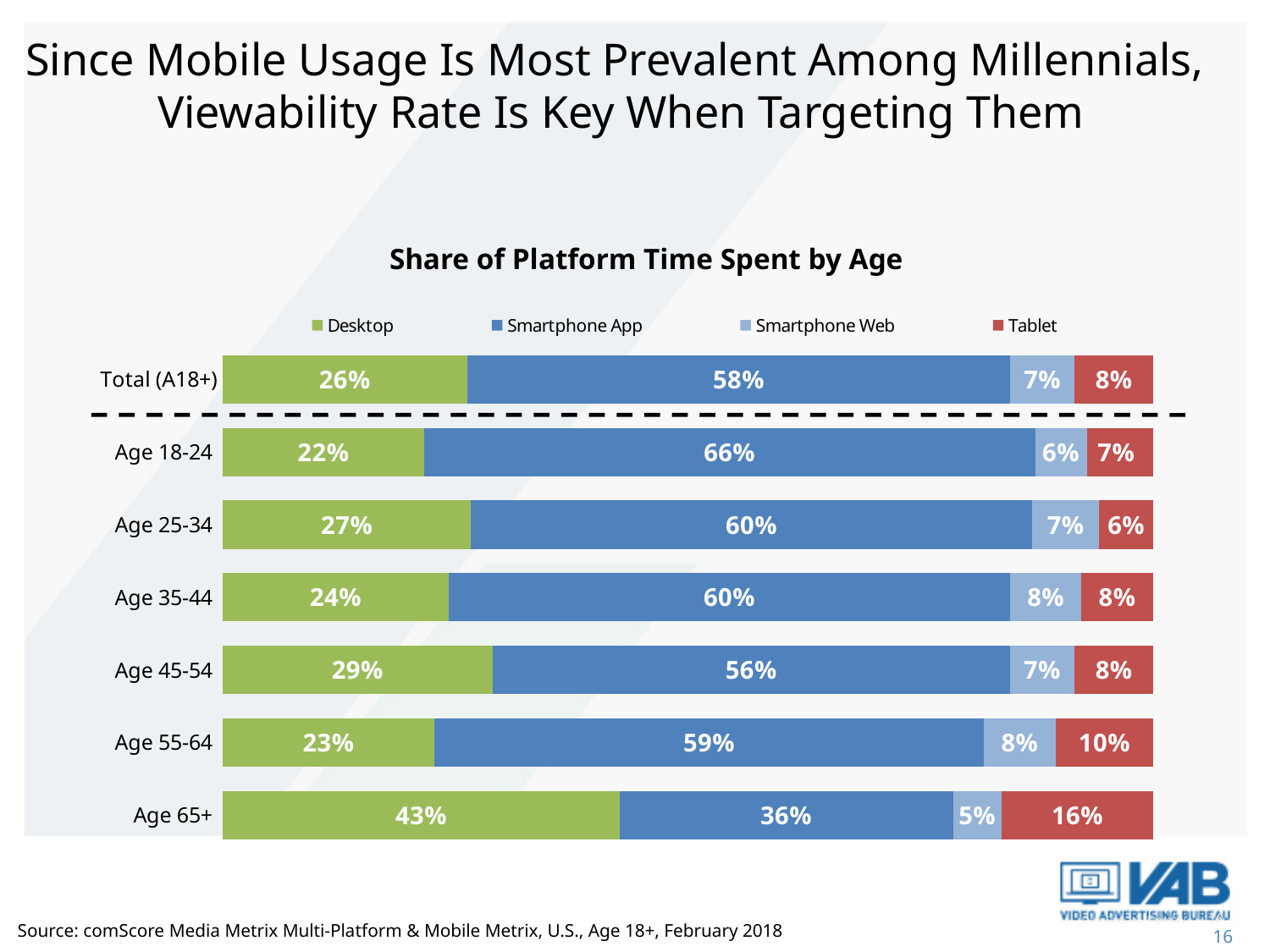
How many age categories (including Total) are shown on the chart? 7 What is the difference between the Desktop share for Age 65+ and the Desktop share for Age 45-54? 14% What is the Tablet share for Age 55-64? 10% Which is larger: the Smartphone App share for Age 25-34 or for Age 45-54? Age 25-34 What is the Smartphone App share for Age 18-24? 66% How many series does the legend list? 4 What is the Desktop share for Age 65+? 43% What is the Smartphone Web share for Total (A18+)? 7% Which age group has the highest Tablet share? Age 65+ Which age group has the highest Smartphone App share? Age 18-24 What type of chart is shown? Stacked bar chart Which age group has the lowest Desktop share? Age 18-24